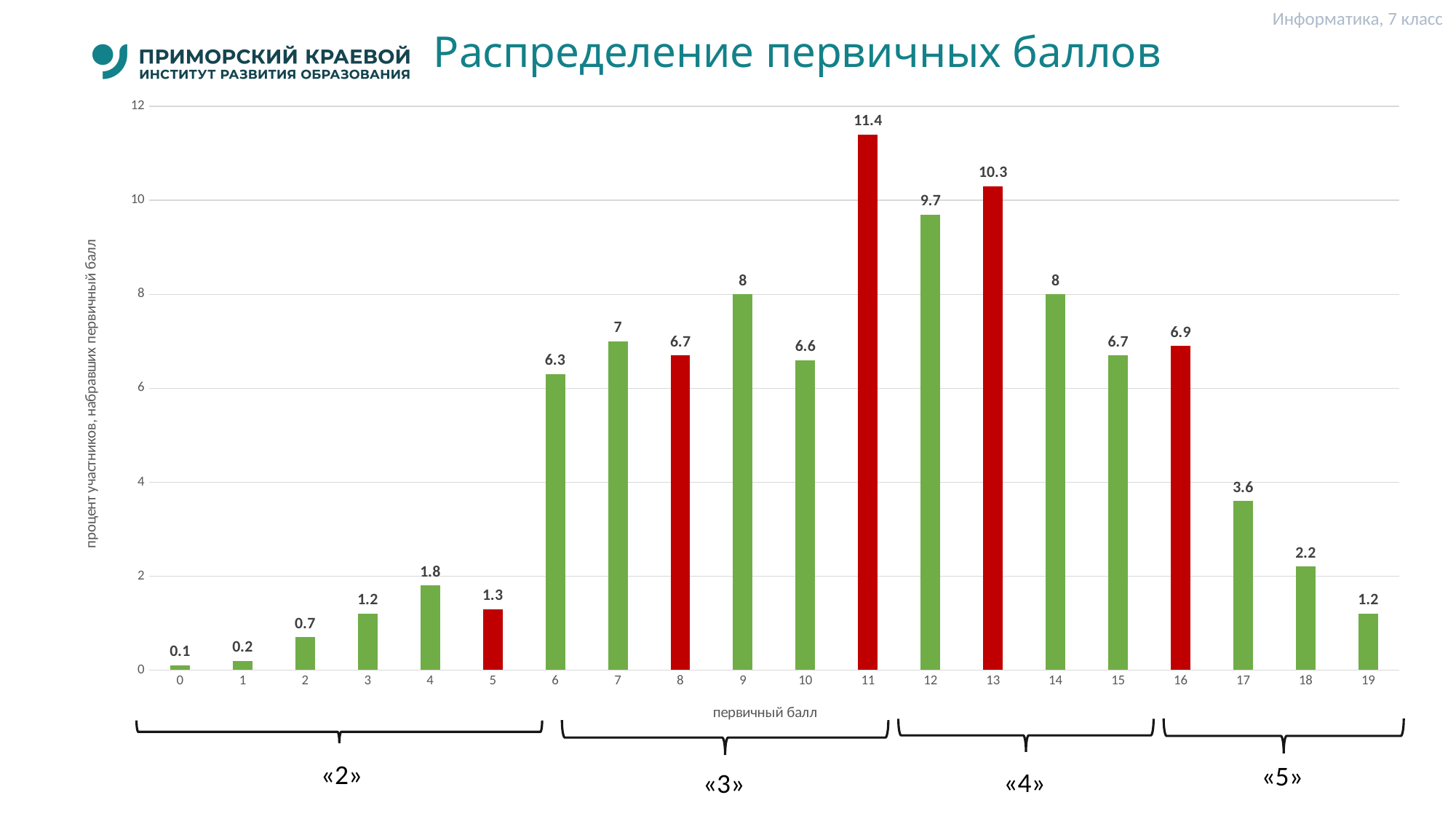
What is the title of the chart? Распределение первичных баллов Which is larger, the value for primary score 12 or for primary score 14? 12 What is the value for primary score 17? 3.6 Which primary score has the highest percentage of participants? 11 What is the value for primary score 11? 11.4 How many primary score categories are shown on the x axis? 20 What is the difference between the values for primary scores 11 and 13? 1.1 What is the value for primary score 13? 10.3 What kind of chart is shown on the slide? bar chart Is the value for primary score 16 greater or less than 6? greater Which primary score has the lowest percentage of participants? 0 Do the values rise or fall from primary score 16 to primary score 19? fall